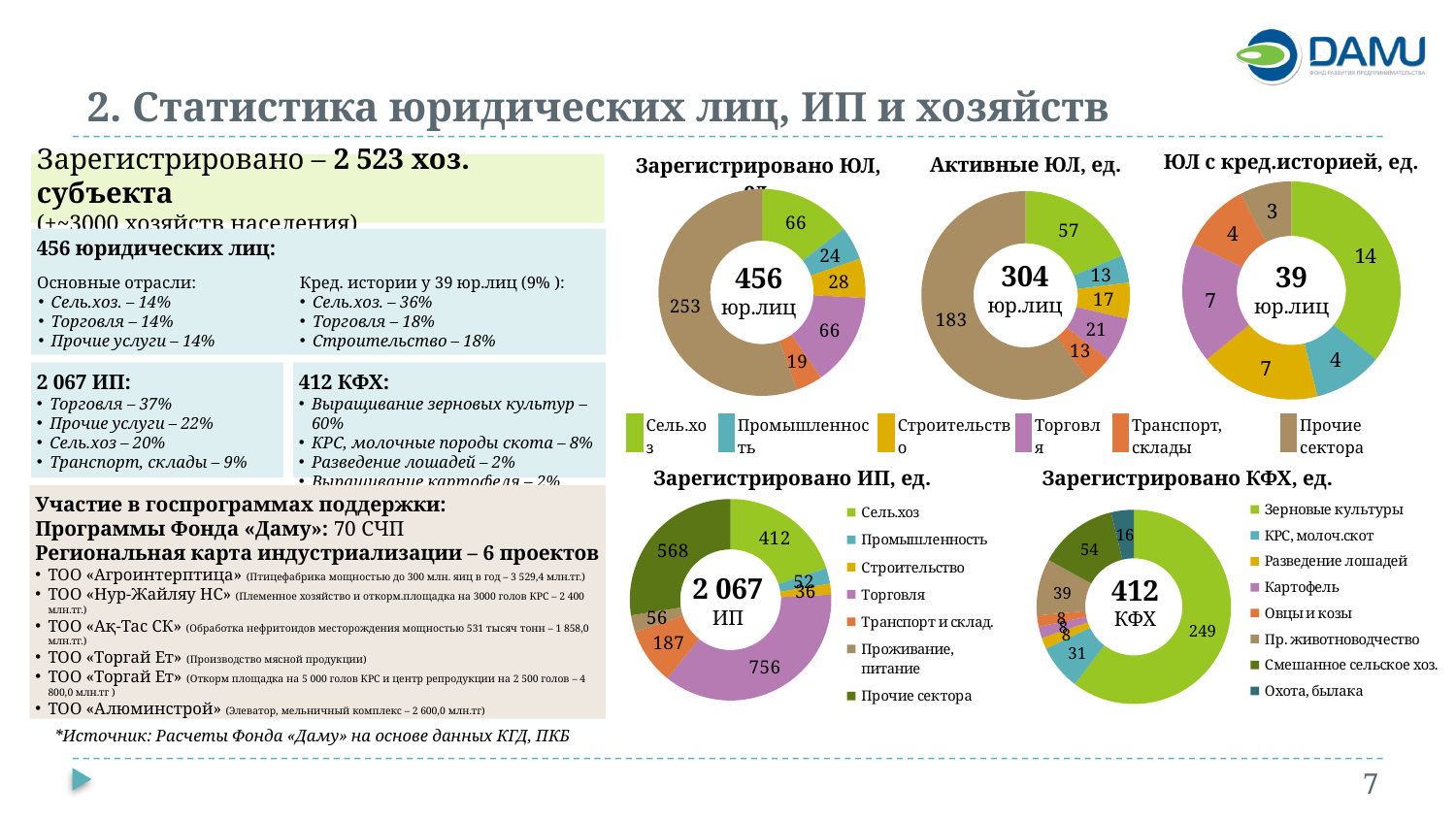
In the chart titled "Зарегистрировано КФХ, ед.", which is larger: Смешанное сельское хоз. or КРС, молоч.скот? Смешанное сельское хоз. In the chart titled "Зарегистрировано ЮЛ, ед.", what is the value for Транспорт, склады? 19 In the chart titled "Активные ЮЛ, ед.", what is the value for Сельхоз? 57 How many entries does the legend of the chart titled "Зарегистрировано ИП, ед." list? 7 What type of chart is the chart titled "Активные ЮЛ, ед."? Donut chart In the chart titled "Зарегистрировано КФХ, ед.", what is the value for Зерновые культуры? 249 In the chart titled "Зарегистрировано ИП, ед.", what is the value for Торговля? 756 In the chart titled "Активные ЮЛ, ед.", which category has the highest value? Прочие сектора In the chart titled "Зарегистрировано ЮЛ, ед.", what is the value for Прочие сектора? 253 In the chart titled "Зарегистрировано ИП, ед.", what is the difference between Торговля and Сельхоз? 344 In the chart titled "ЮЛ с кред.историей, ед.", which category has the lowest value? Прочие сектора In the chart titled "ЮЛ с кред.историей, ед.", what is the value for Сельхоз? 14